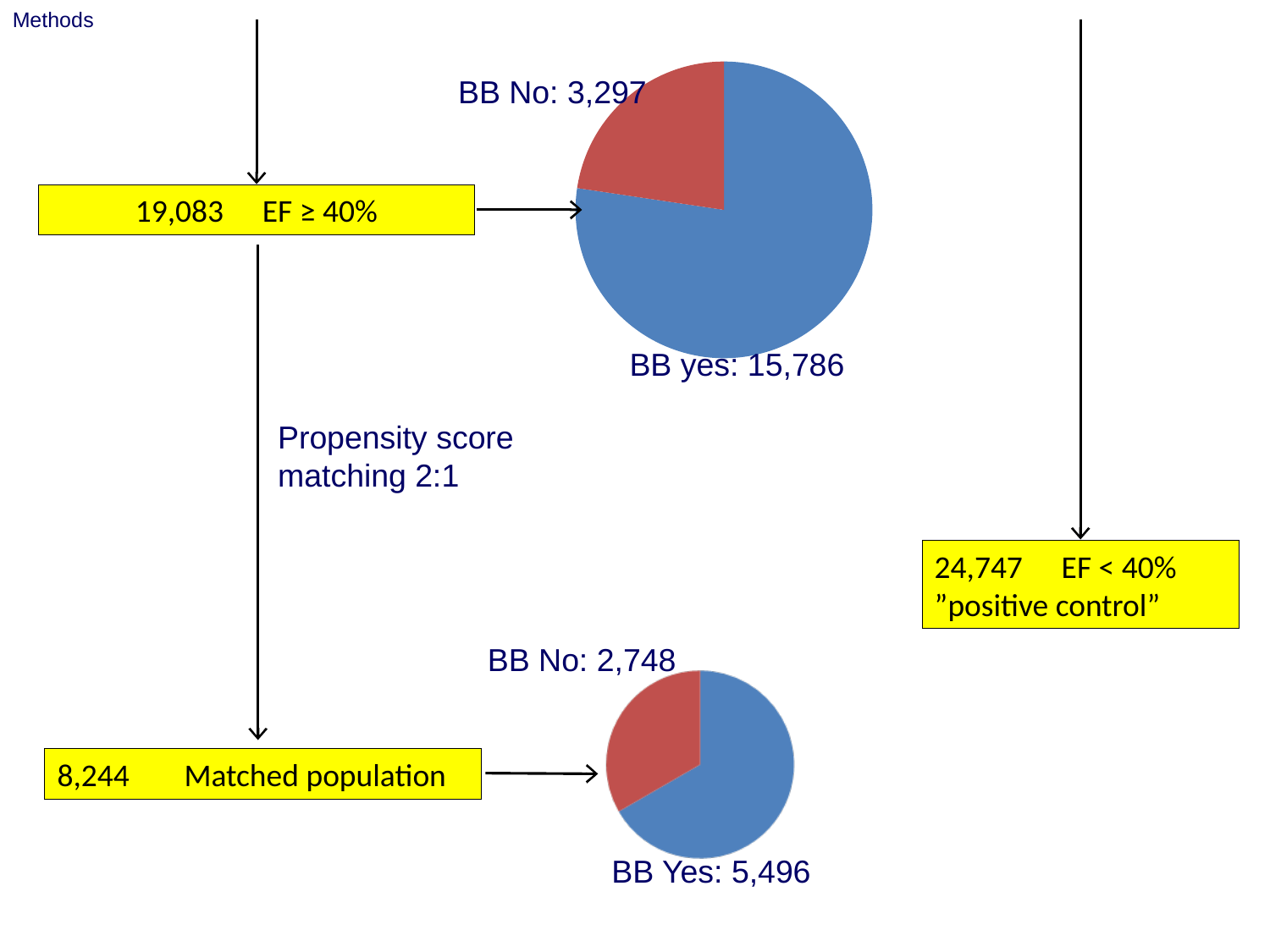
In the lower pie chart, what share of the total does the BB No slice represent? 33.3% What type of chart is used next to the EF ≥ 40% box? Pie chart In the lower pie chart, which slice is the smallest? BB No In the upper pie chart (next to the EF ≥ 40% box), what is the value for BB yes? 15,786 In the lower pie chart (next to the Matched population box), what is the value for BB Yes? 5,496 In the upper pie chart, which slice is larger, BB yes or BB No? BB yes In the upper pie chart, what is the difference between the BB yes and BB No values? 12,489 How many slices does the lower pie chart have? 2 In the upper pie chart, what share of the total does the BB yes slice represent? 82.7% In the lower pie chart, what is the difference between the BB Yes and BB No values? 2,748 In the upper pie chart (next to the EF ≥ 40% box), what is the value for BB No? 3,297 In the lower pie chart (next to the Matched population box), what is the value for BB No? 2,748